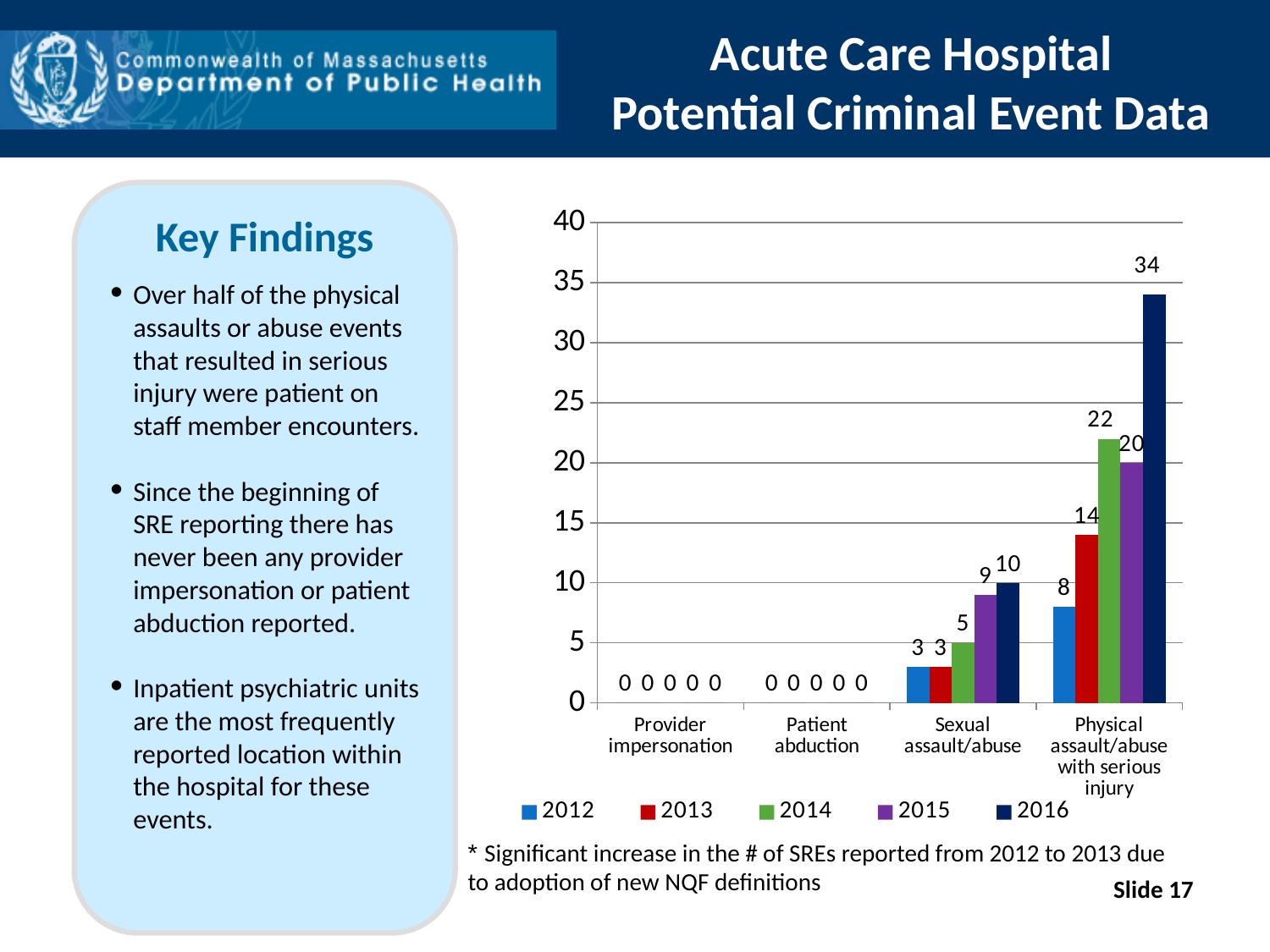
Is the value for 2016 in the Physical assault/abuse with serious injury category greater or less than 30? greater What is the difference between the 2016 and 2015 values in the Physical assault/abuse with serious injury category? 14 Which is larger in the Physical assault/abuse with serious injury category: the 2014 value or the 2013 value? 2014 What is the value for 2015 in the Sexual assault/abuse category? 9 What is the value for 2016 in the Physical assault/abuse with serious injury category? 34 How many categories are shown on the x axis? 4 What is the value for 2012 in the Physical assault/abuse with serious injury category? 8 How many series does the legend list? 5 Do the values in the Sexual assault/abuse category rise or fall from 2012 to 2016? rise What kind of chart is shown on the slide? bar chart What is the value for 2014 in the Sexual assault/abuse category? 5 Which year has the highest value in the Physical assault/abuse with serious injury category? 2016